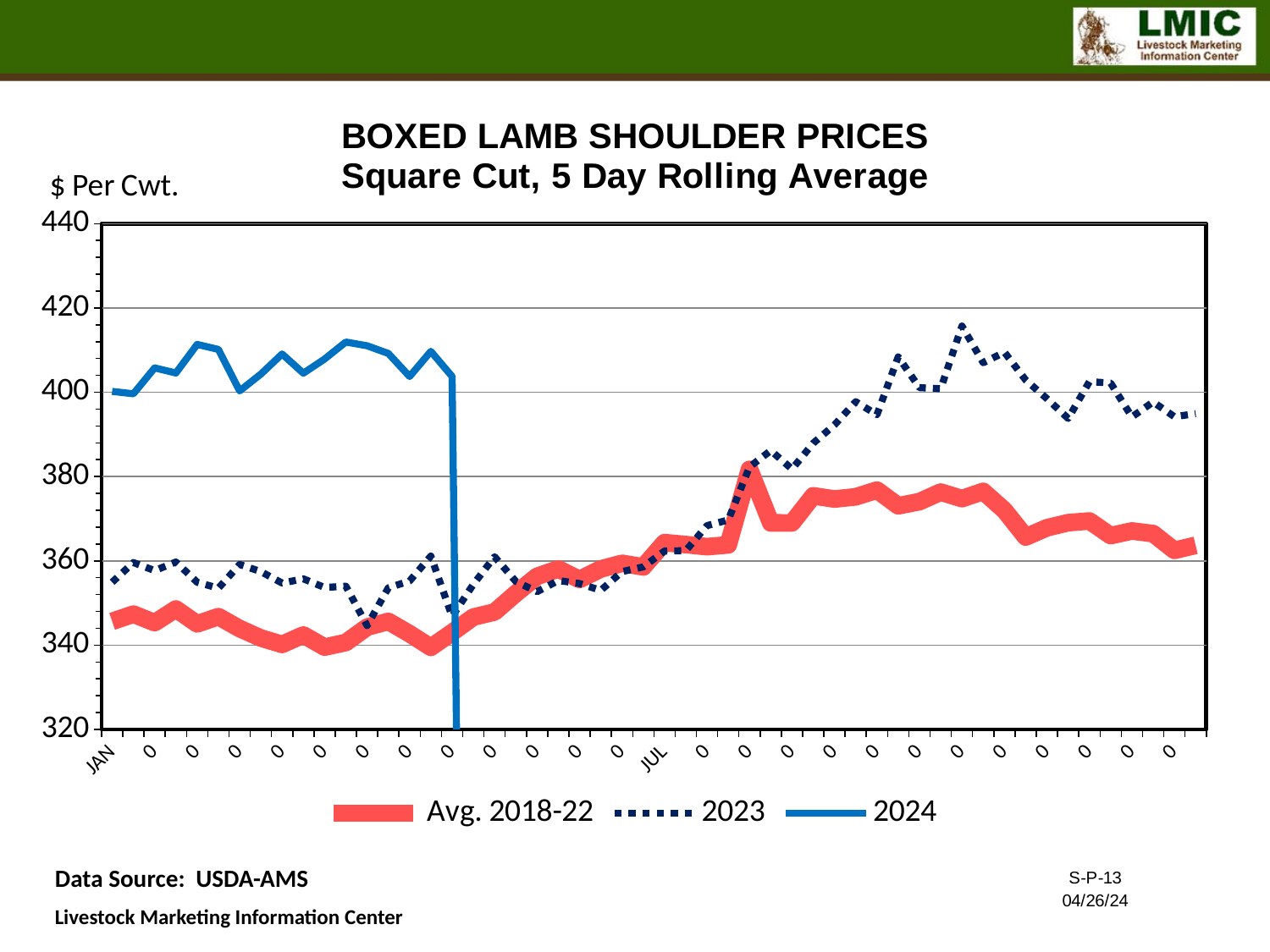
At JAN, which series has the higher value: 2024 or Avg. 2018-22? 2024 What unit is shown on the vertical axis of the chart? $ Per Cwt. At JAN, which series has the higher value: 2023 or Avg. 2018-22? 2023 What kind of chart is shown on the slide? line chart How many series does the legend list? 3 Is the highest value of the 2023 series greater or less than 400? greater Is the value of the Avg. 2018-22 series at JAN greater or less than 360? less Is the highest value of the Avg. 2018-22 series greater or less than 380? greater Does the 2023 series generally rise or fall from JUL to the end of the year? rise What is the title of the chart? BOXED LAMB SHOULDER PRICES Square Cut, 5 Day Rolling Average Which series has the highest value at JAN? 2024